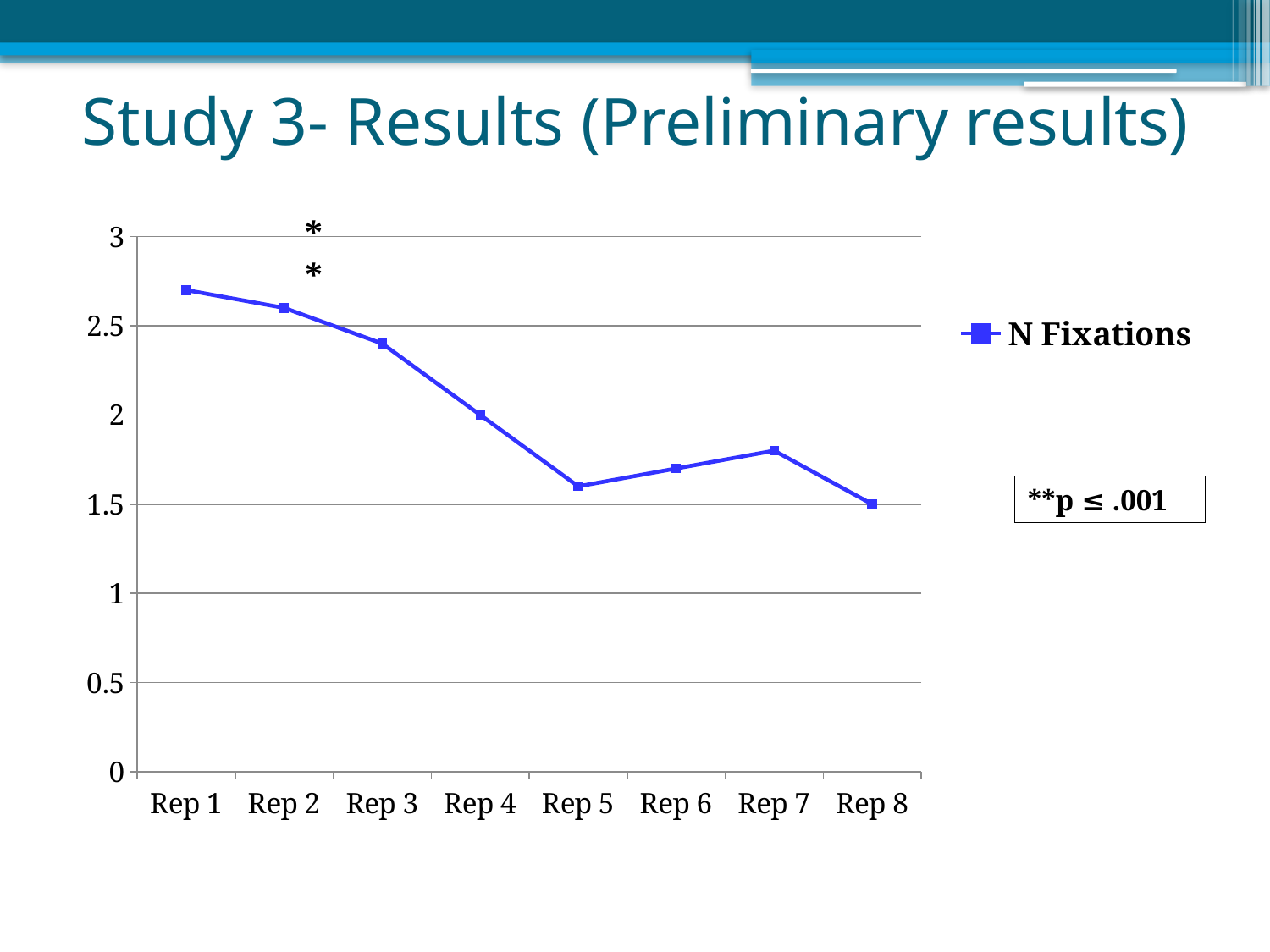
How many repetitions (points) are plotted along the x axis? 8 How many series does the legend list? 1 What is the value of N Fixations at Rep 4? 2 Which repetition has the lowest number of fixations? Rep 8 Is the value for Rep 5 greater or less than 2? less What kind of chart is shown on the slide? line chart Is the value for Rep 1 greater or less than 2.5? greater What is the name of the series shown in the legend? N Fixations Which repetition has the highest number of fixations? Rep 1 What is the value of N Fixations at Rep 8? 1.5 Which has more fixations, Rep 3 or Rep 7? Rep 3 Overall, do the N Fixations values rise or fall from Rep 1 to Rep 8? fall